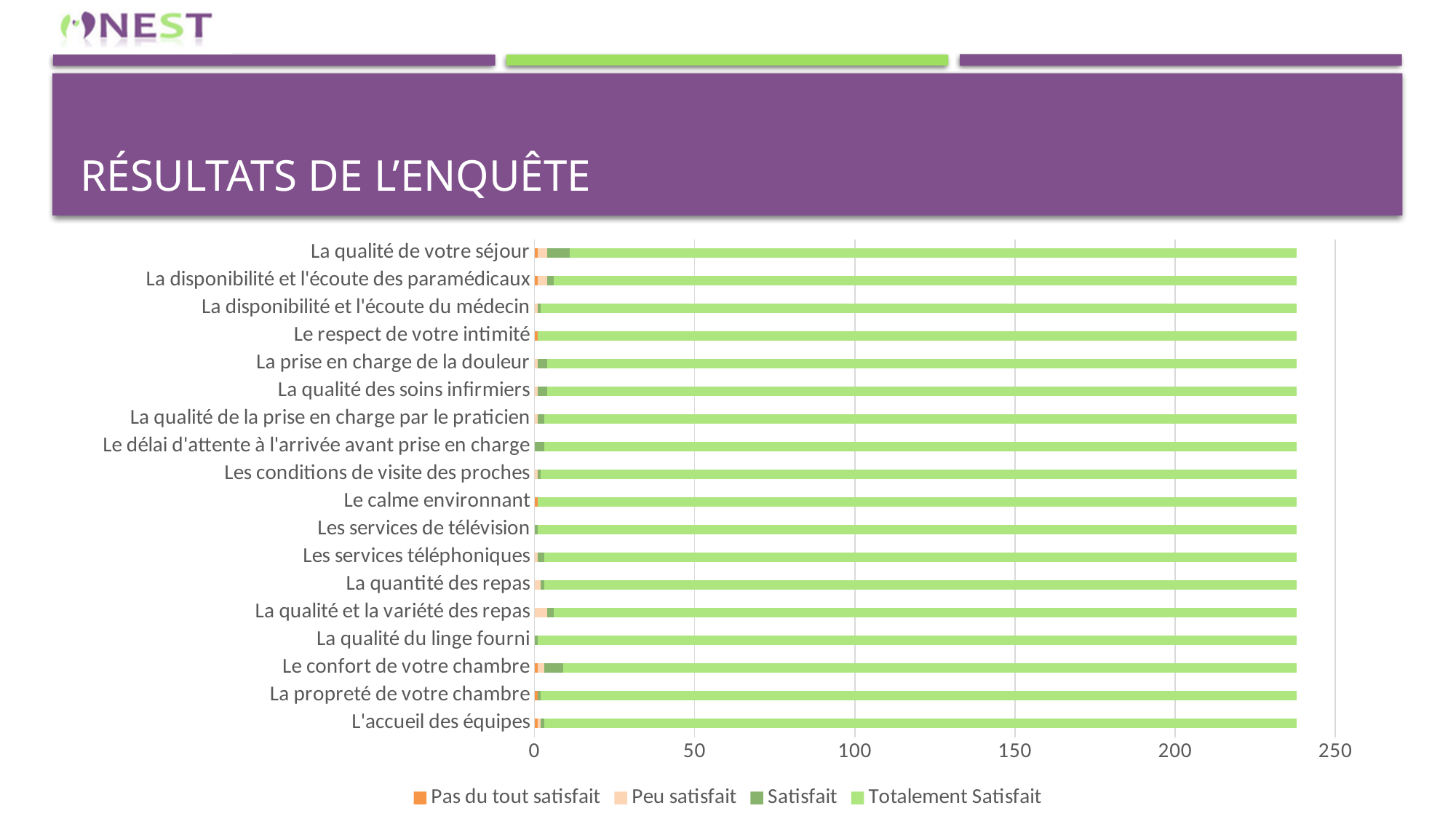
Which has the larger "Peu satisfait" segment: "La qualité et la variété des repas" or "Les services de télévision"? La qualité et la variété des repas What is the title shown in the banner above the chart? RÉSULTATS DE L'ENQUÊTE What kind of chart is shown on the slide? Stacked horizontal bar chart What are the four series named in the chart legend? Pas du tout satisfait, Peu satisfait, Satisfait, Totalement Satisfait How many categories (survey items) are listed on the vertical axis of the chart? 18 Is the total bar length for "L'accueil des équipes" greater or less than 250? less What is the highest value labelled on the horizontal axis of the chart? 250 How many series does the chart legend list? 4 Which has the larger "Satisfait" segment: "Le confort de votre chambre" or "La qualité du linge fourni"? Le confort de votre chambre Is the "Satisfait" segment for "La qualité du linge fourni" greater or less than 50? less Is the total bar length for "Le confort de votre chambre" greater or less than 200? greater